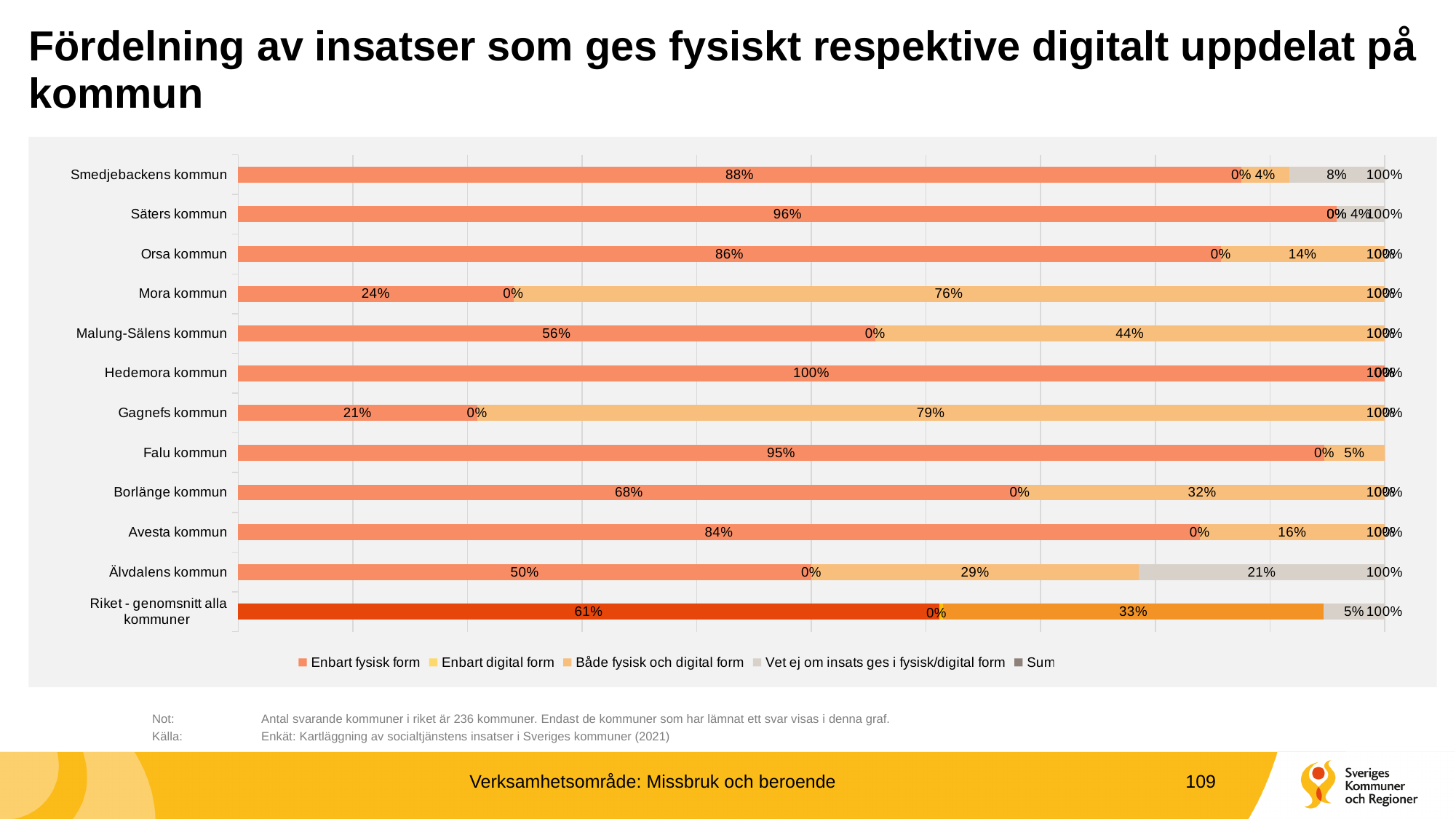
How many series does the legend list? 5 What is the value of Både fysisk och digital form for Gagnefs kommun? 79% Which has a larger value for Enbart fysisk form, Malung-Sälens kommun or Älvdalens kommun? Malung-Sälens kommun How many categories (rows) are shown on the y axis of the chart? 12 Which kommun has the lowest value for Enbart fysisk form? Gagnefs kommun What is the value of Enbart fysisk form for Mora kommun? 24% What is the first entry in the chart's legend? Enbart fysisk form Which kommun has the highest value for Enbart fysisk form? Hedemora kommun What is the value of Vet ej om insats ges i fysisk/digital form for Älvdalens kommun? 21% What kind of chart is shown on the slide? Stacked horizontal bar chart For Borlänge kommun, what is the difference between Enbart fysisk form and Både fysisk och digital form? 36 percentage points What is the value of Både fysisk och digital form for Riket - genomsnitt alla kommuner? 33%